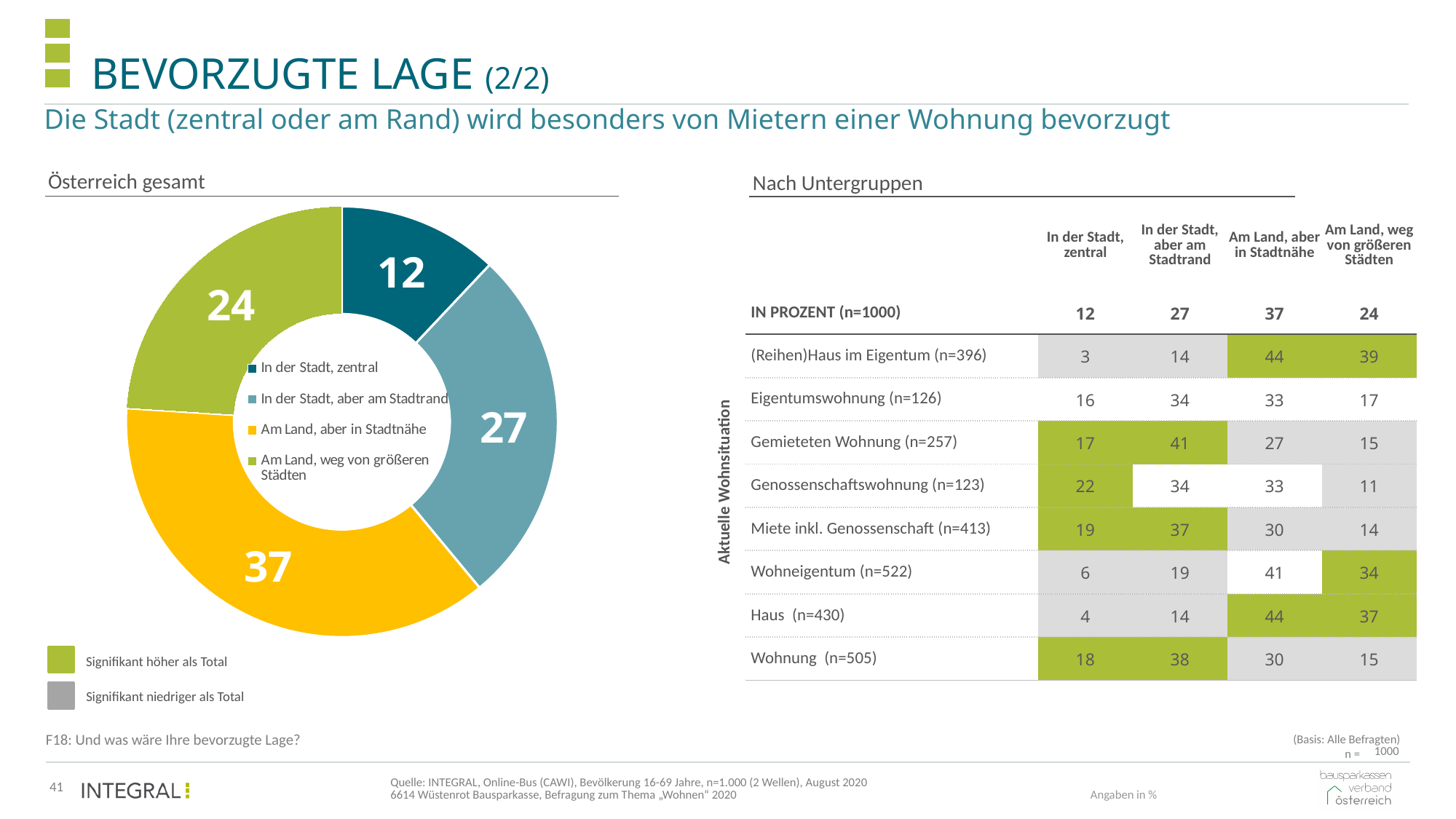
In the "Österreich gesamt" donut chart, what is the value for "In der Stadt, zentral"? 12 In the "Österreich gesamt" donut chart, what is the value for "Am Land, aber in Stadtnähe"? 37 In the "Österreich gesamt" donut chart, what is the value for "In der Stadt, aber am Stadtrand"? 27 In the "Österreich gesamt" donut chart, what is the value for "Am Land, weg von größeren Städten"? 24 In the "Österreich gesamt" donut chart, what is the combined value of the two "In der Stadt" slices? 39 What type of chart is shown under "Österreich gesamt"? Donut (pie) chart In the "Österreich gesamt" donut chart, what is the difference between the values for "Am Land, aber in Stadtnähe" and "In der Stadt, aber am Stadtrand"? 10 In the "Österreich gesamt" donut chart, which category has the largest slice? Am Land, aber in Stadtnähe In the "Österreich gesamt" donut chart, which category has the smallest slice? In der Stadt, zentral How many slices does the "Österreich gesamt" donut chart have? 4 In the "Österreich gesamt" donut chart, which is larger: "In der Stadt, aber am Stadtrand" or "Am Land, weg von größeren Städten"? In der Stadt, aber am Stadtrand In the "Österreich gesamt" donut chart, which colour represents "Am Land, aber in Stadtnähe"? Yellow